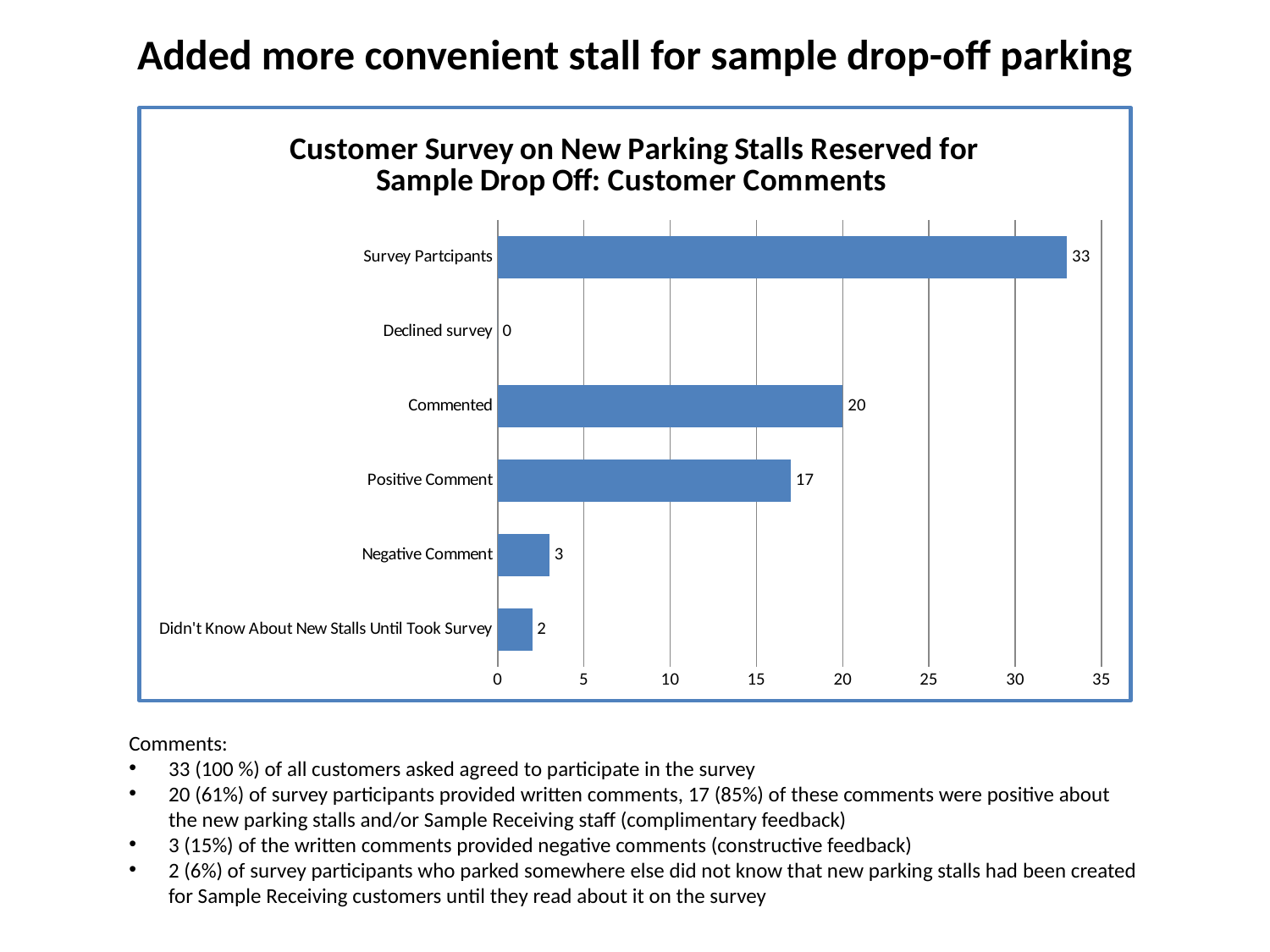
What kind of chart is shown on the slide? Bar chart What is the title of the chart? Customer Survey on New Parking Stalls Reserved for Sample Drop Off: Customer Comments What is the value for Survey Partcipants? 33 What is the value for Positive Comment? 17 What is the value for Declined survey? 0 Which is larger, the value for Negative Comment or the value for Didn't Know About New Stalls Until Took Survey? Negative Comment Which category has the lowest value? Declined survey How many categories are shown in the chart? 6 What is the value for Commented? 20 What is the value for Negative Comment? 3 What is the difference between the values for Commented and Positive Comment? 3 Which category has the highest value? Survey Partcipants